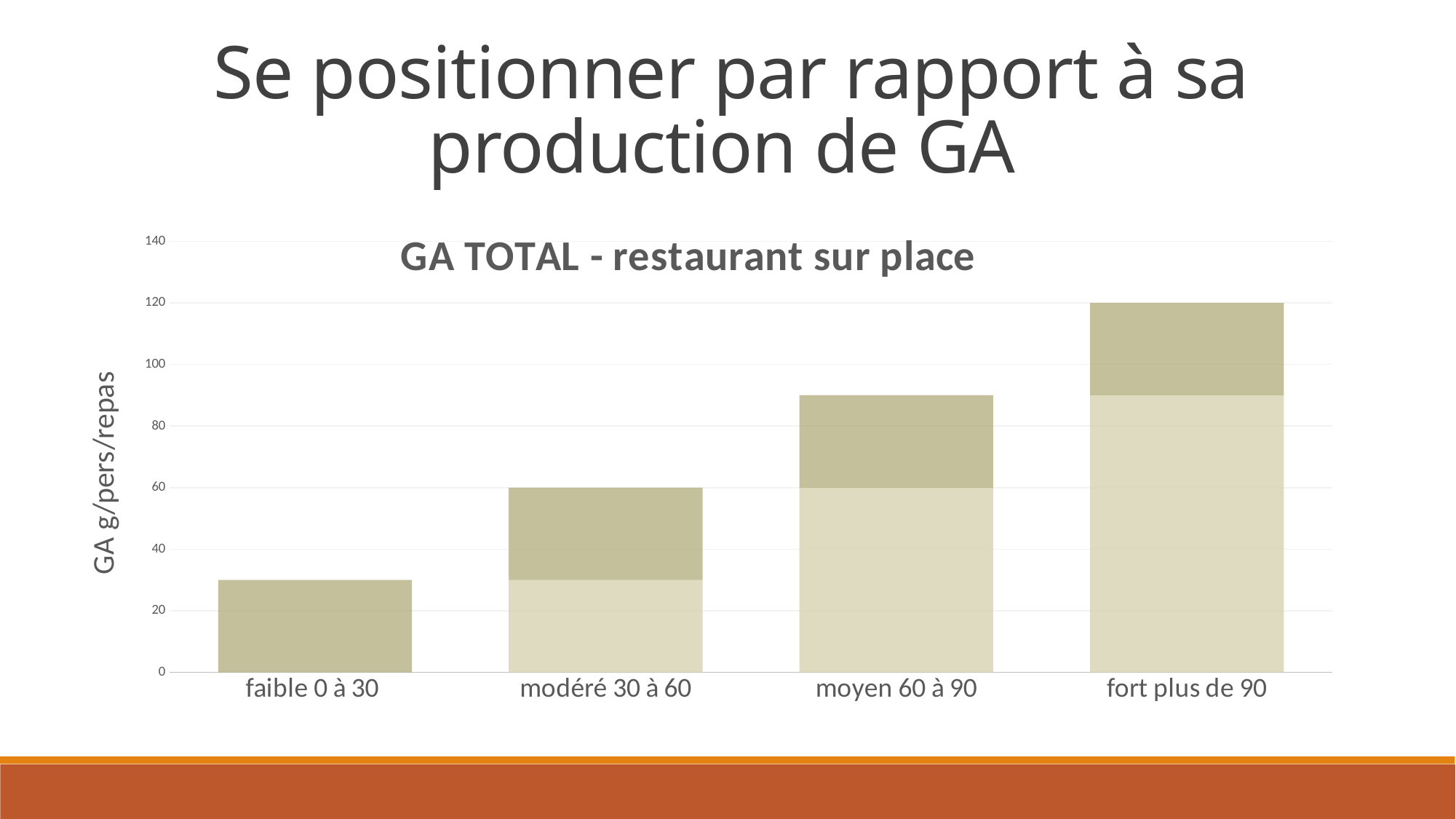
What kind of chart is shown on the slide? bar chart What is the total value of the bar for 'fort plus de 90'? 120 Is the value for 'faible 0 à 30' greater or less than 40? less Which category has the highest total bar? fort plus de 90 What is the title of the chart? GA TOTAL - restaurant sur place What is the difference between the total bar for 'fort plus de 90' and the total bar for 'modéré 30 à 60'? 60 What is the label of the vertical axis? GA g/pers/repas How many categories are shown on the x axis? 4 Which category has the lowest bar? faible 0 à 30 Do the bar totals rise or fall from left to right along the x axis? rise What is the total value of the bar for 'modéré 30 à 60'? 60 Is the total value for 'moyen 60 à 90' greater or less than 80? greater